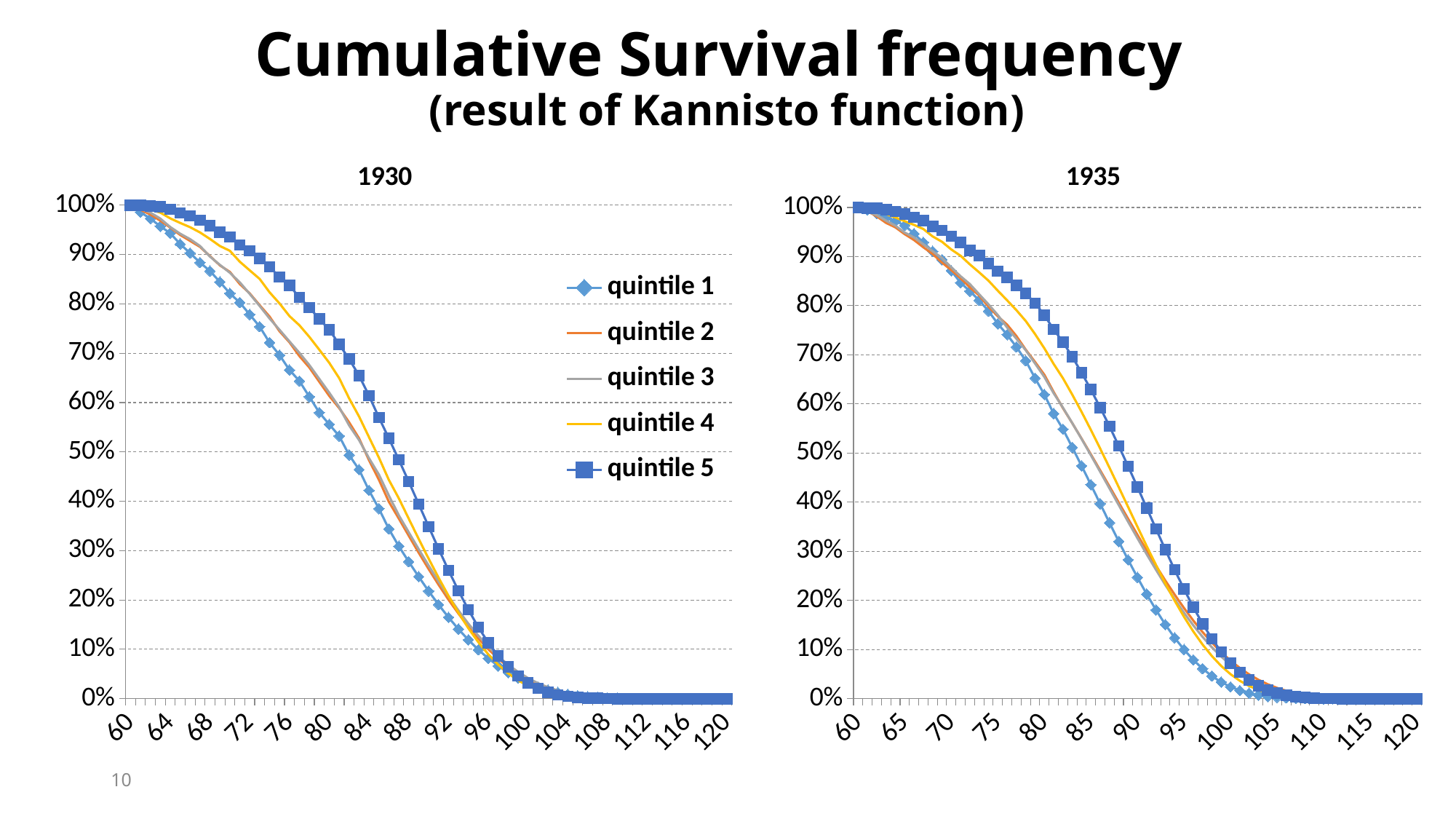
In the 1930 chart, is the value for quintile 1 at age 88 greater or less than 40%? less In the 1935 chart, what is the value of quintile 5 at age 60? 100% How many series does the legend list? 5 In the 1930 chart, is the value for quintile 5 at age 80 greater or less than 70%? greater In the 1930 chart, do the values rise or fall as age increases along the x axis? fall In the 1930 chart, which quintile has the highest value at age 80? quintile 5 What is the title of the chart on the right? 1935 What kind of chart is the 1930 chart? line chart In the 1930 chart, which quintile has the lowest value at age 80? quintile 1 In the 1935 chart, at age 85, which is larger: quintile 5 or quintile 1? quintile 5 In the 1930 chart, what is the value of quintile 1 at age 120? 0% In the 1935 chart, is the value for quintile 5 at age 85 greater or less than 60%? greater